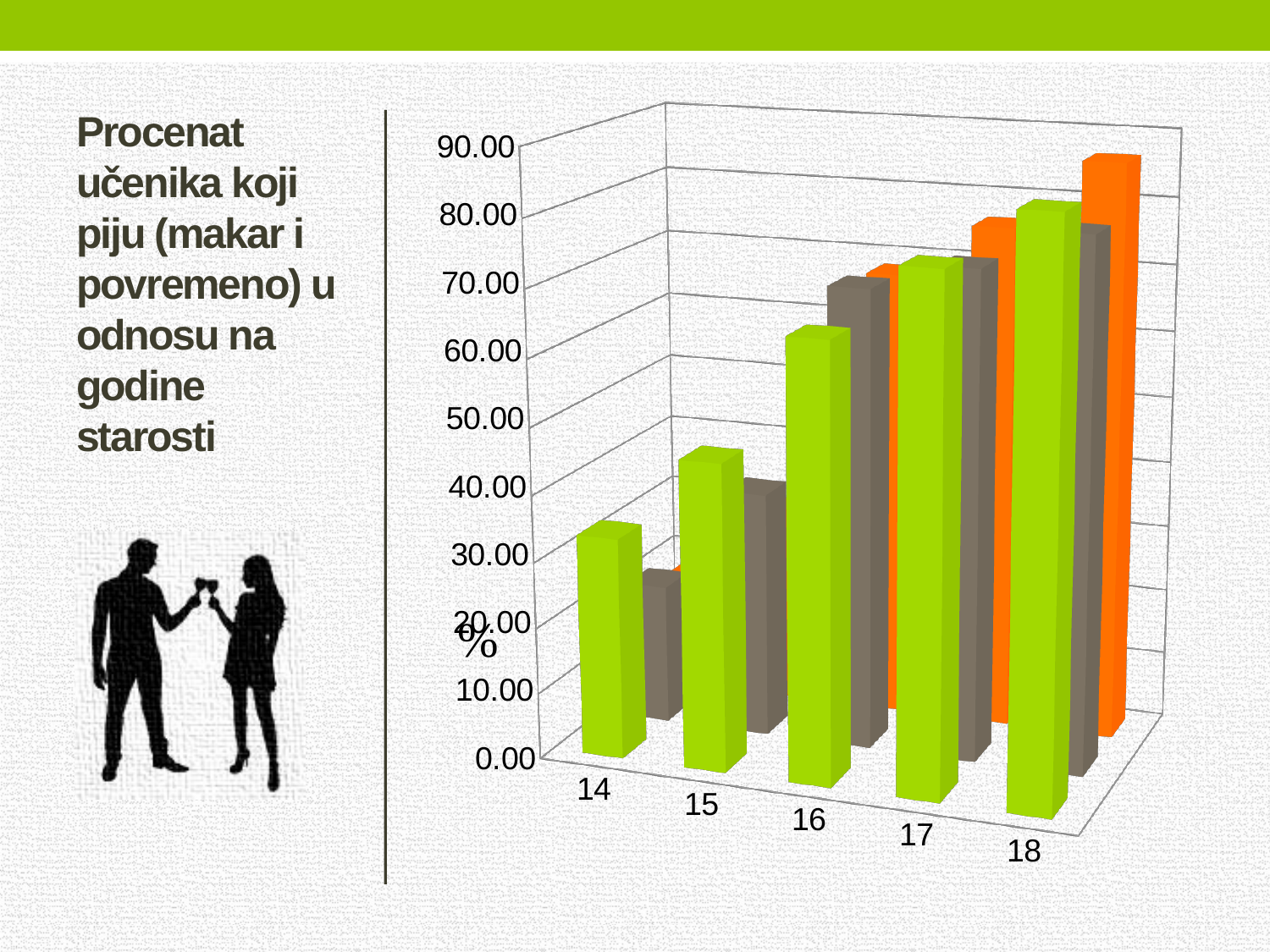
What label is shown on the vertical axis of the chart? % Is the green bar for age 18 greater or less than 70.00? greater For which age is the green bar the lowest? 14 For which age is the green bar the highest? 18 Is the green bar for age 16 greater or less than 50.00? greater Do the values of the green bars rise or fall as age increases from 14 to 18? rise Which is larger: the gray bar for age 14 or the gray bar for age 16? age 16 Which is larger: the green bar for age 15 or the green bar for age 17? age 17 How many age categories are shown on the x axis of the chart? 5 What is the title of the chart on the slide? Procenat učenika koji piju (makar i povremeno) u odnosu na godine starosti Is the green bar for age 14 greater or less than 50.00? less What kind of chart is shown on the slide? bar chart